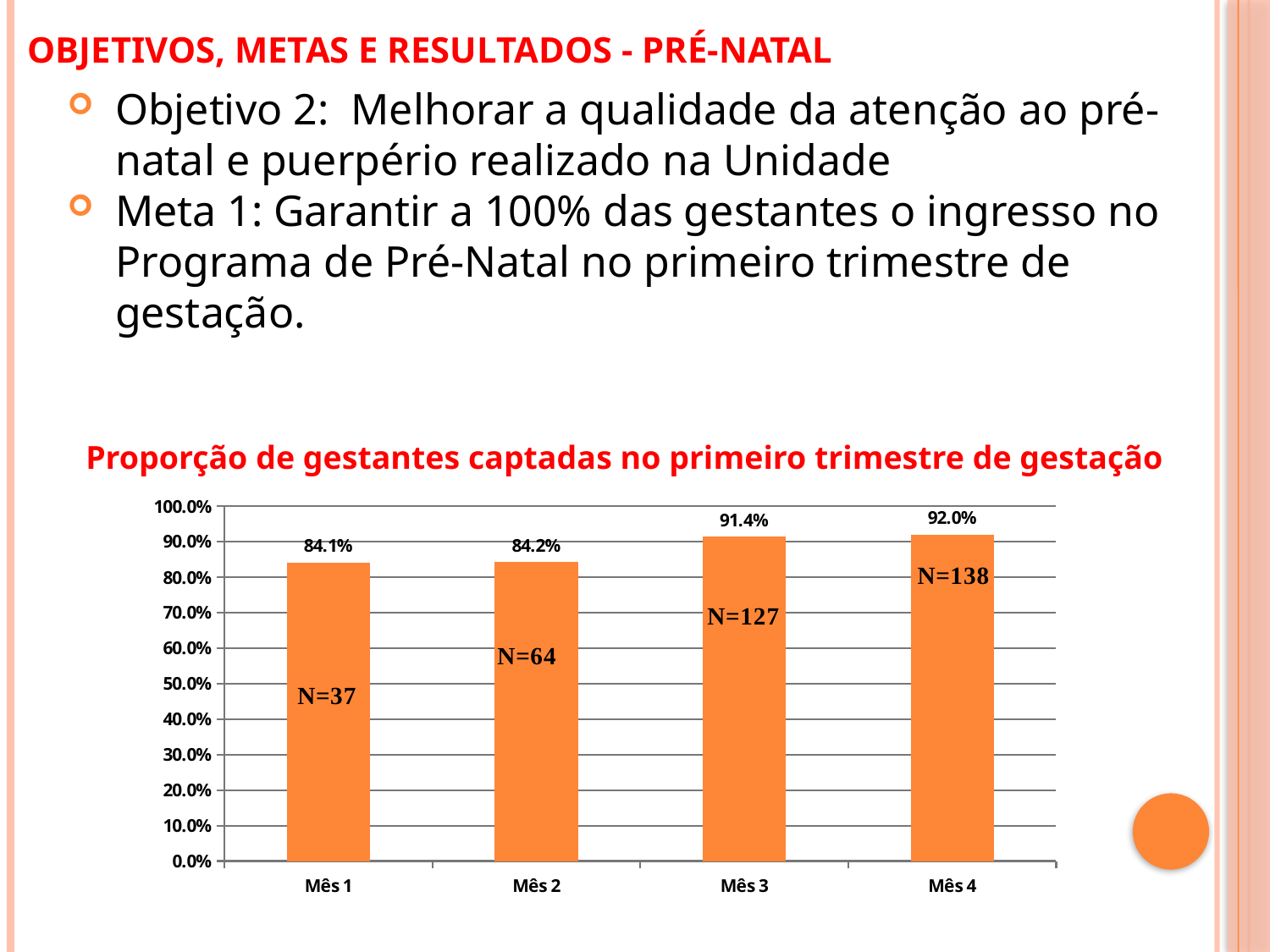
What is the title of the chart? Proporção de gestantes captadas no primeiro trimestre de gestação Which is larger, the value for Mês 3 or the value for Mês 2? Mês 3 What kind of chart is shown? bar chart What is the value for Mês 3? 91.4% Do the values rise or fall from Mês 1 to Mês 4? rise Is the value for Mês 2 greater or less than 90.0%? less What is the difference between the values for Mês 4 and Mês 1? 7.9% Which month has the lowest proportion? Mês 1 How many months are shown on the x axis? 4 What is the N value shown inside the bar for Mês 4? N=138 What is the value for Mês 1? 84.1% Which month has the highest proportion? Mês 4